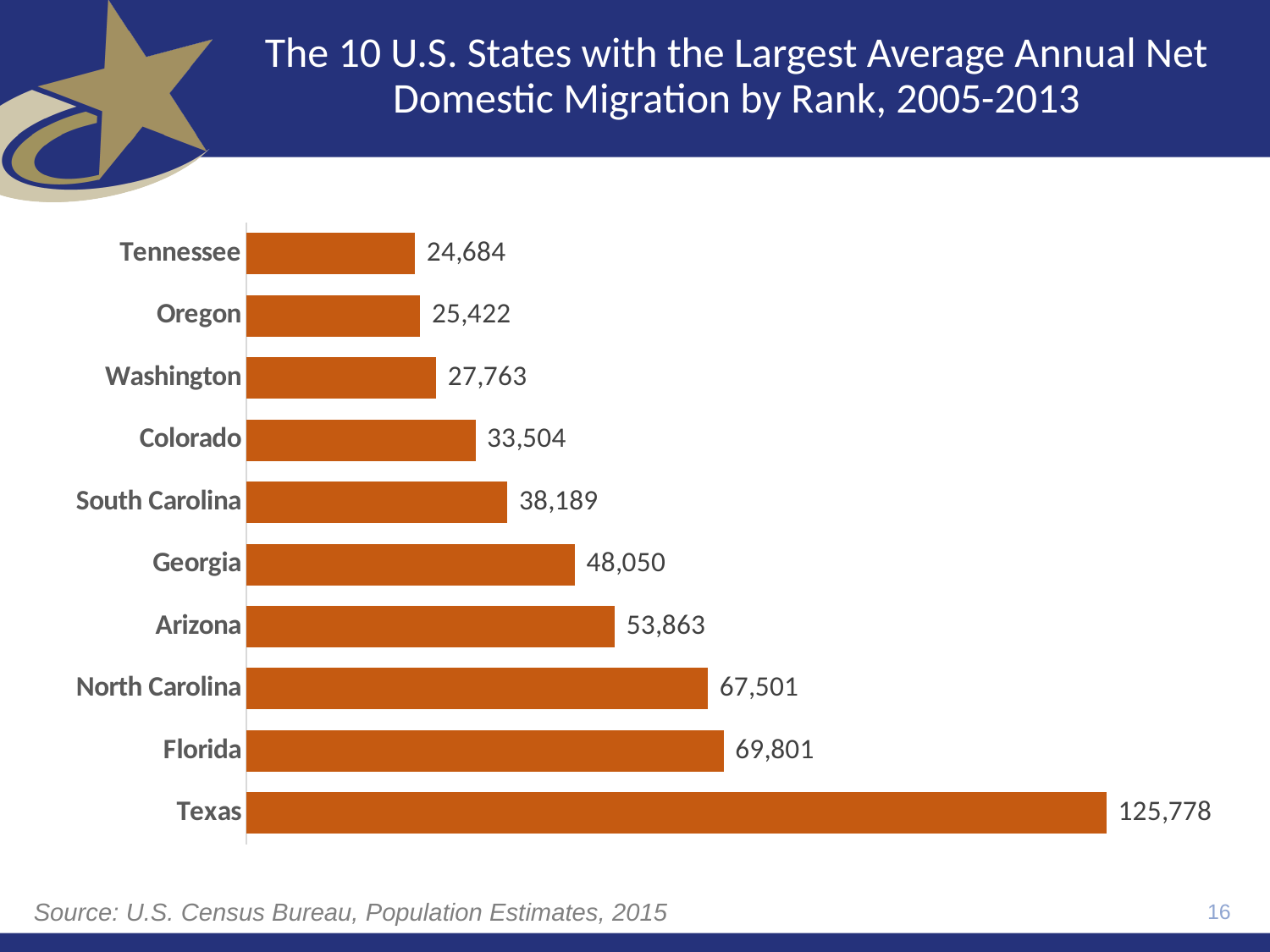
What is the difference between the values for Florida and North Carolina? 2,300 Which state has the lowest value on the chart? Tennessee Which has a larger value, Georgia or Arizona? Arizona What is the average annual net domestic migration value shown for Texas? 125,778 Which has a larger value, Colorado or South Carolina? South Carolina What value is shown for North Carolina? 67,501 What kind of chart is shown on the slide? Bar chart What is the difference between the values for Texas and Florida? 55,977 Which state has the highest value on the chart? Texas How many states are shown on the chart? 10 What is the source cited for the chart data? U.S. Census Bureau, Population Estimates, 2015 What value is shown for Tennessee? 24,684